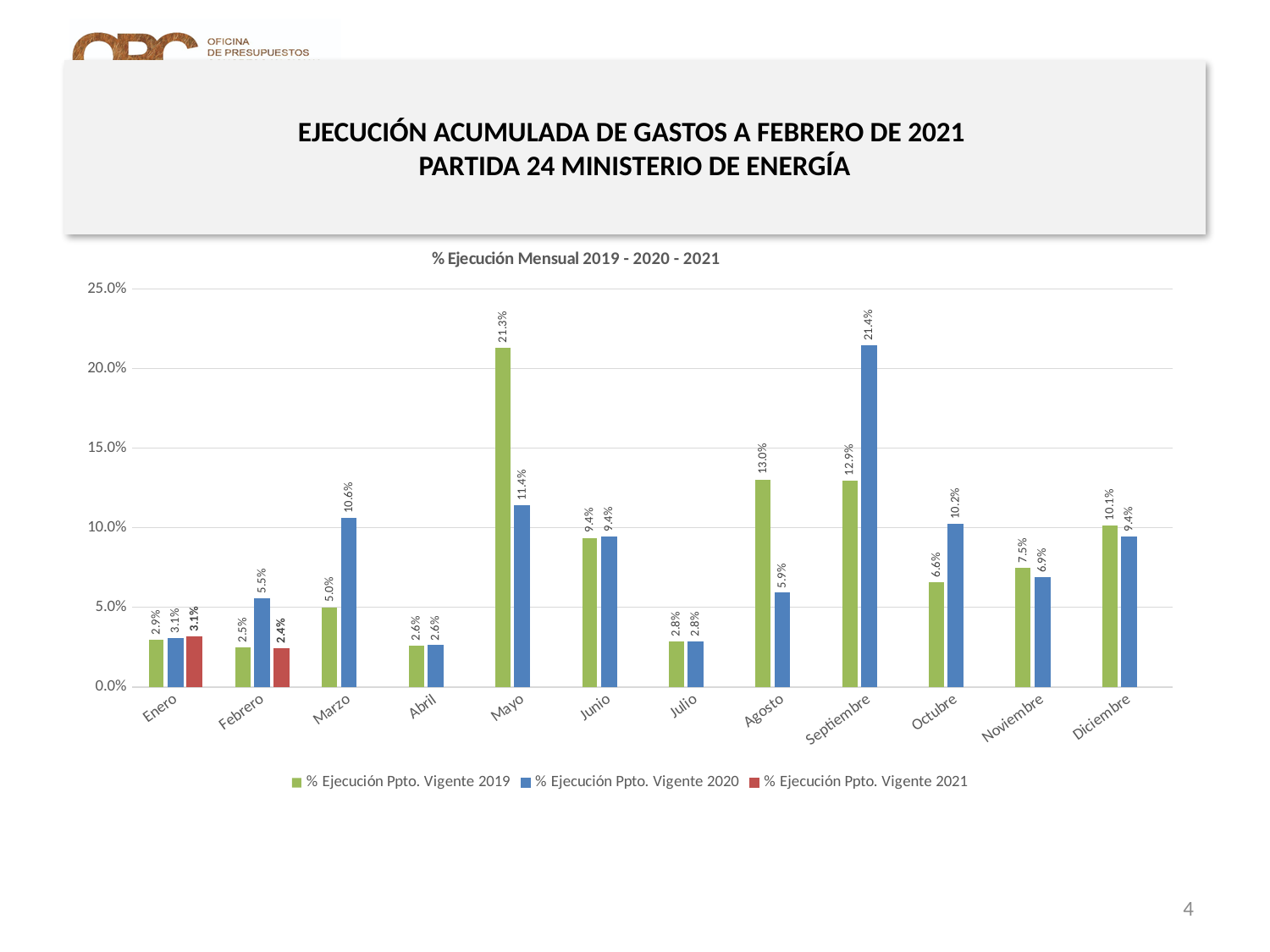
What is the title of the chart? % Ejecución Mensual 2019 - 2020 - 2021 Is the value for % Ejecución Ppto. Vigente 2020 in Octubre greater or less than 10.0%? greater What is the value for % Ejecución Ppto. Vigente 2021 in Febrero? 2.4% What is the value for % Ejecución Ppto. Vigente 2019 in Mayo? 21.3% In Agosto, which series is larger: % Ejecución Ppto. Vigente 2019 or % Ejecución Ppto. Vigente 2020? % Ejecución Ppto. Vigente 2019 What is the value for % Ejecución Ppto. Vigente 2020 in Septiembre? 21.4% Which month has the highest value for % Ejecución Ppto. Vigente 2019? Mayo How many series does the legend list? 3 Which month has the lowest value for % Ejecución Ppto. Vigente 2020? Abril What is the difference between the 2020 and 2019 values in Marzo? 5.6% What kind of chart is shown on the slide? Bar chart How many months are shown on the x axis? 12